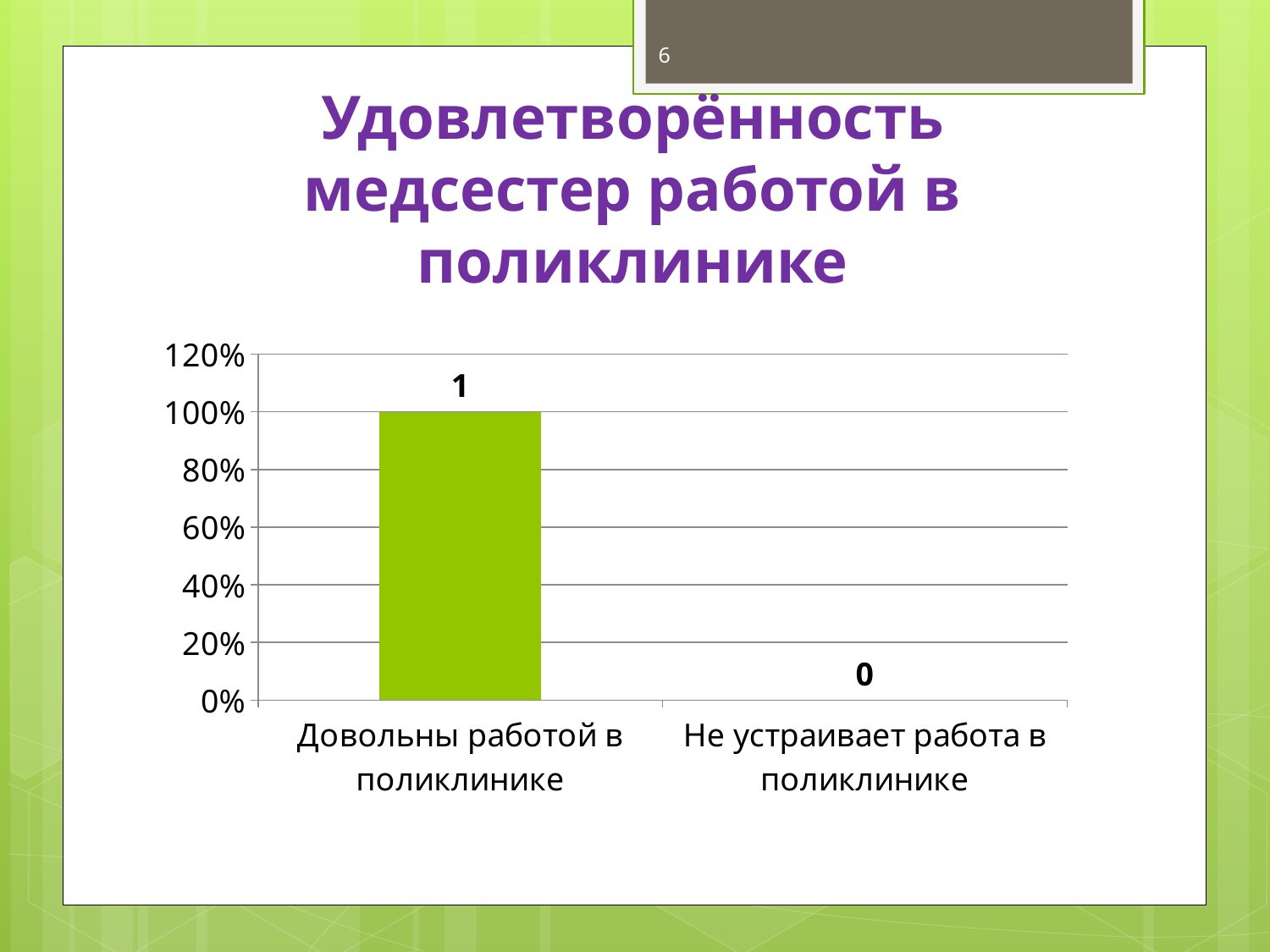
What kind of chart is shown on the slide? Bar chart What is the data label shown for "Не устраивает работа в поликлинике"? 0 What is the highest value shown on the vertical axis? 120% Which category has the highest value? Довольны работой в поликлинике What is the data label shown for "Довольны работой в поликлинике"? 1 Is the value for "Довольны работой в поликлинике" greater or less than 80%? greater Which is larger: the value for "Довольны работой в поликлинике" or for "Не устраивает работа в поликлинике"? Довольны работой в поликлинике How many categories are shown on the chart? 2 Which category has the lowest value? Не устраивает работа в поликлинике What is the title of the slide containing the chart? Удовлетворённость медсестер работой в поликлинике Which axis tick does the bar for "Довольны работой в поликлинике" reach on the vertical axis? 100% Is the value for "Не устраивает работа в поликлинике" greater or less than 20%? less